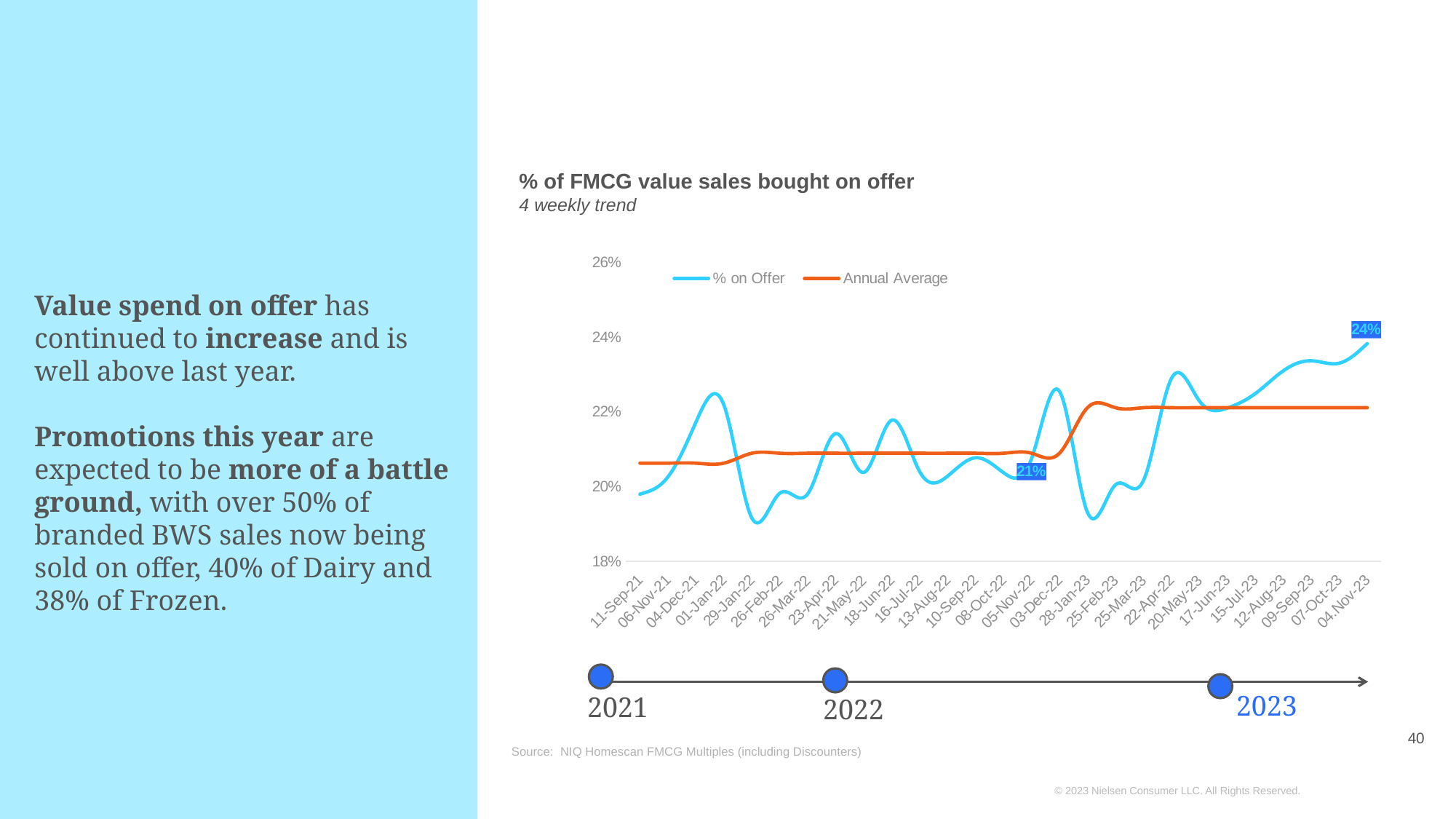
Is the % on Offer value at 01-Jan-22 greater or less than 22%? greater Is the % on Offer value at 28-Jan-23 greater or less than 20%? less How many series does the chart legend list? 2 At which date does the % on Offer line reach its highest point? 04-Nov-23 Is the % on Offer value at 11-Sep-21 greater or less than 20%? less Which of the two labelled % on Offer values is larger, 05-Nov-22 or 04-Nov-23? 04-Nov-23 What kind of chart is shown on the slide? Line chart What is the % on Offer value labelled at 04-Nov-23? 24% Does the % on Offer line overall rise or fall from the start of the period to the end? Rise What is the title of the chart? % of FMCG value sales bought on offer By how many percentage points did the labelled % on Offer value rise from 05-Nov-22 to 04-Nov-23? 3 percentage points What is the % on Offer value labelled at 05-Nov-22? 21%